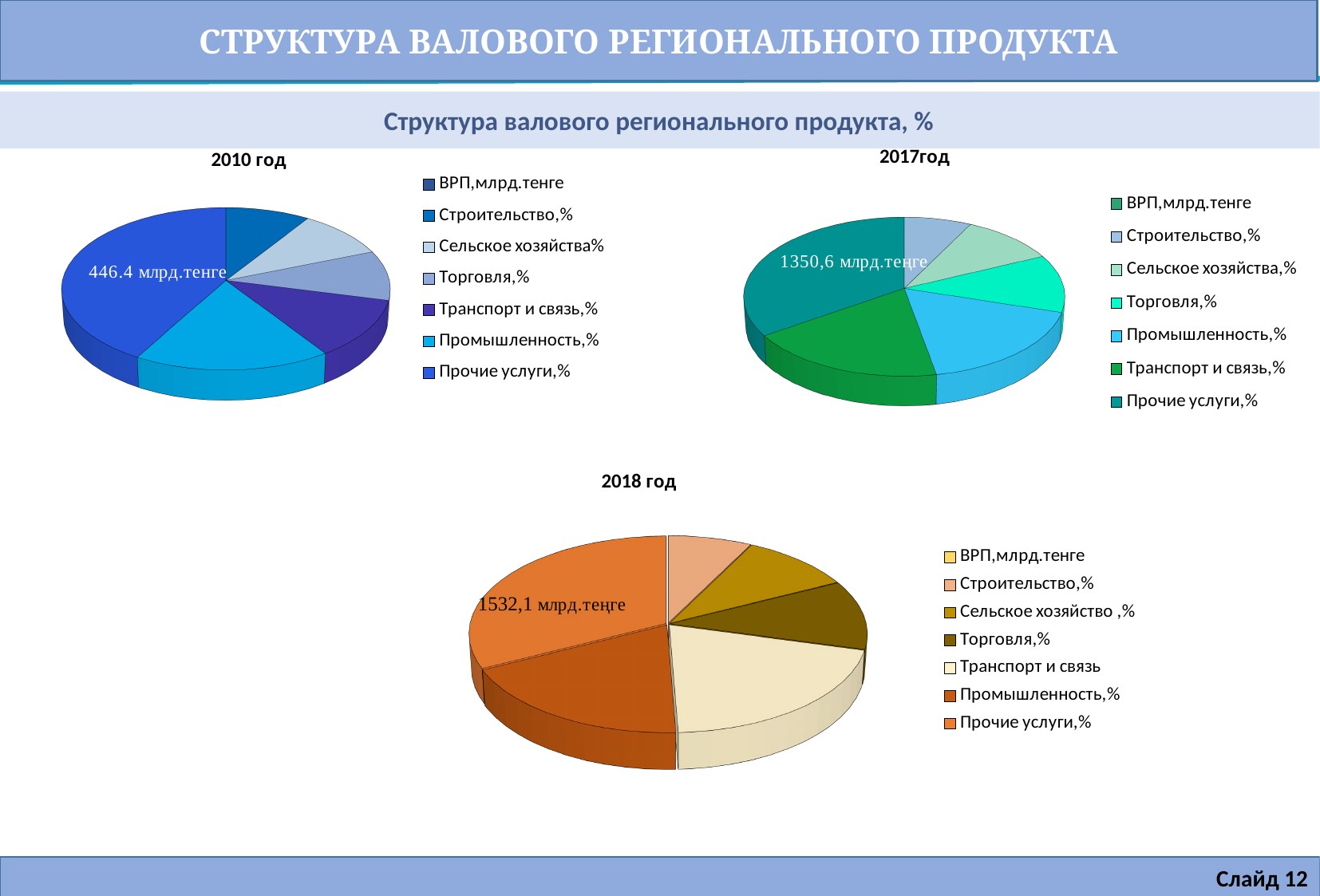
How many entries does the legend of the 2018 год chart list? 7 In the 2018 год chart, what value is printed on the pie? 1532,1 млрд.тенге Is the ВРП value printed on the 2017год chart larger or smaller than the one printed on the 2010 год chart? Larger What is the difference between the ВРП value printed on the 2018 год chart and the one printed on the 2017год chart? 181,5 млрд.тенге What kind of chart is used for the 2010 год chart? Pie chart In the 2010 год chart, what value is printed on the pie? 446.4 млрд.тенге Which of the three charts shows the smallest ВРП value in млрд.тенге? 2010 год Which legend entry in the 2018 год chart is shown in orange? Прочие услуги,% How many pie charts are shown on the slide? 3 In the 2017год chart, what value is printed on the pie? 1350,6 млрд.тенге Which of the three charts shows the largest ВРП value in млрд.тенге? 2018 год What is the title shown above the three charts? Структура валового регионального продукта, %